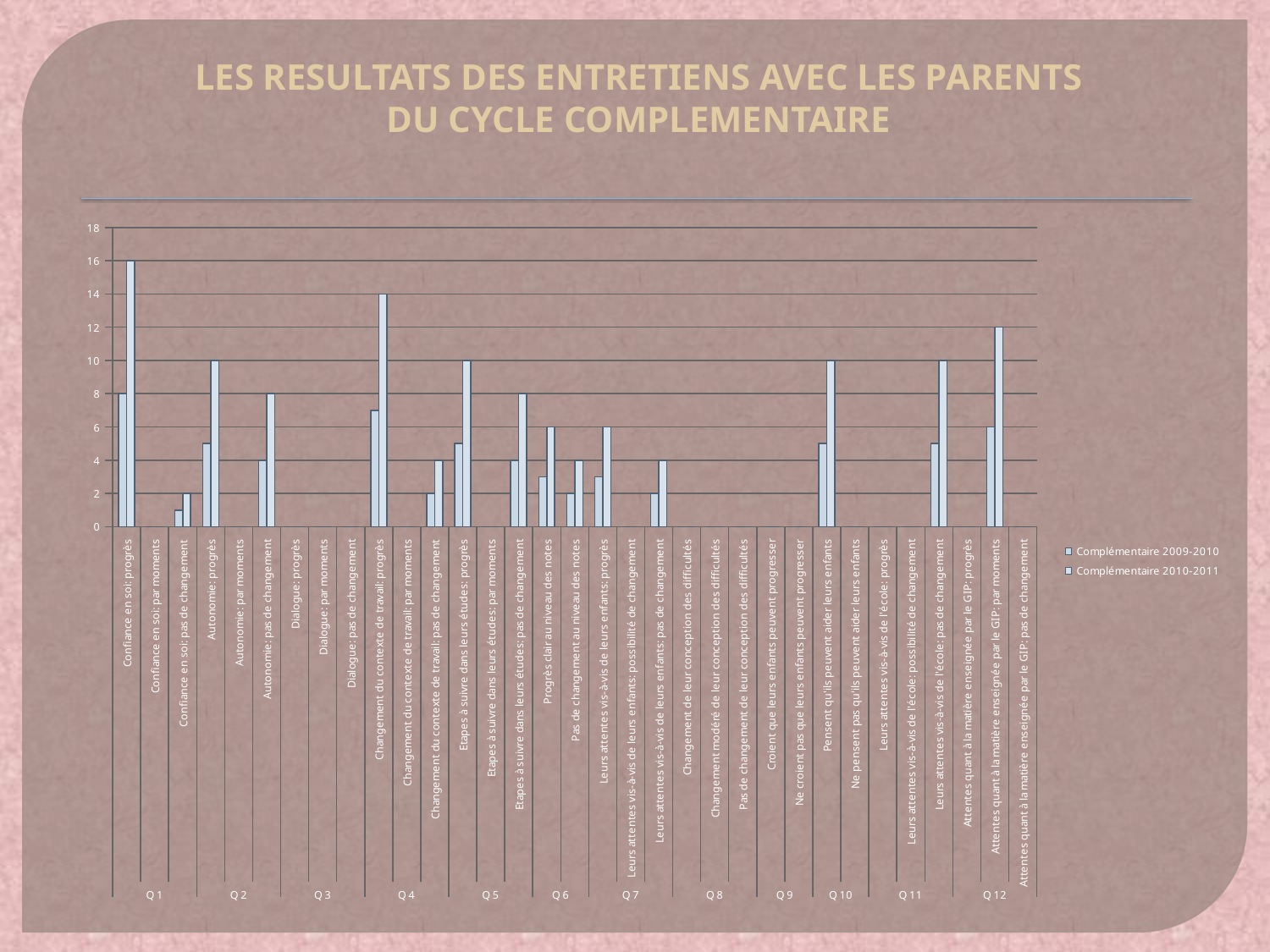
What is the value for 'Confiance en soi: progrès' in the Complémentaire 2010-2011 series? 16 What is the value for 'Changement du contexte de travail: progrès' in the Complémentaire 2010-2011 series? 14 What is the difference between the Complémentaire 2010-2011 and Complémentaire 2009-2010 values for 'Confiance en soi: progrès'? 8 What kind of chart is shown on the slide? bar chart What is the value for 'Confiance en soi: progrès' in the Complémentaire 2009-2010 series? 8 How many question groups (Q1 to Q12) are labelled along the x axis? 12 Is the Complémentaire 2009-2010 value for 'Changement du contexte de travail: progrès' greater or less than 6? greater What are the two series named in the legend? Complémentaire 2009-2010 and Complémentaire 2010-2011 Which category has the highest bar on the chart? Confiance en soi: progrès Is the Complémentaire 2010-2011 value for 'Attentes quant à la matière enseignée par le GIP: par moments' greater or less than 10? greater Which is larger for 'Autonomie: progrès': the Complémentaire 2009-2010 value or the Complémentaire 2010-2011 value? Complémentaire 2010-2011 How many series does the legend list? 2